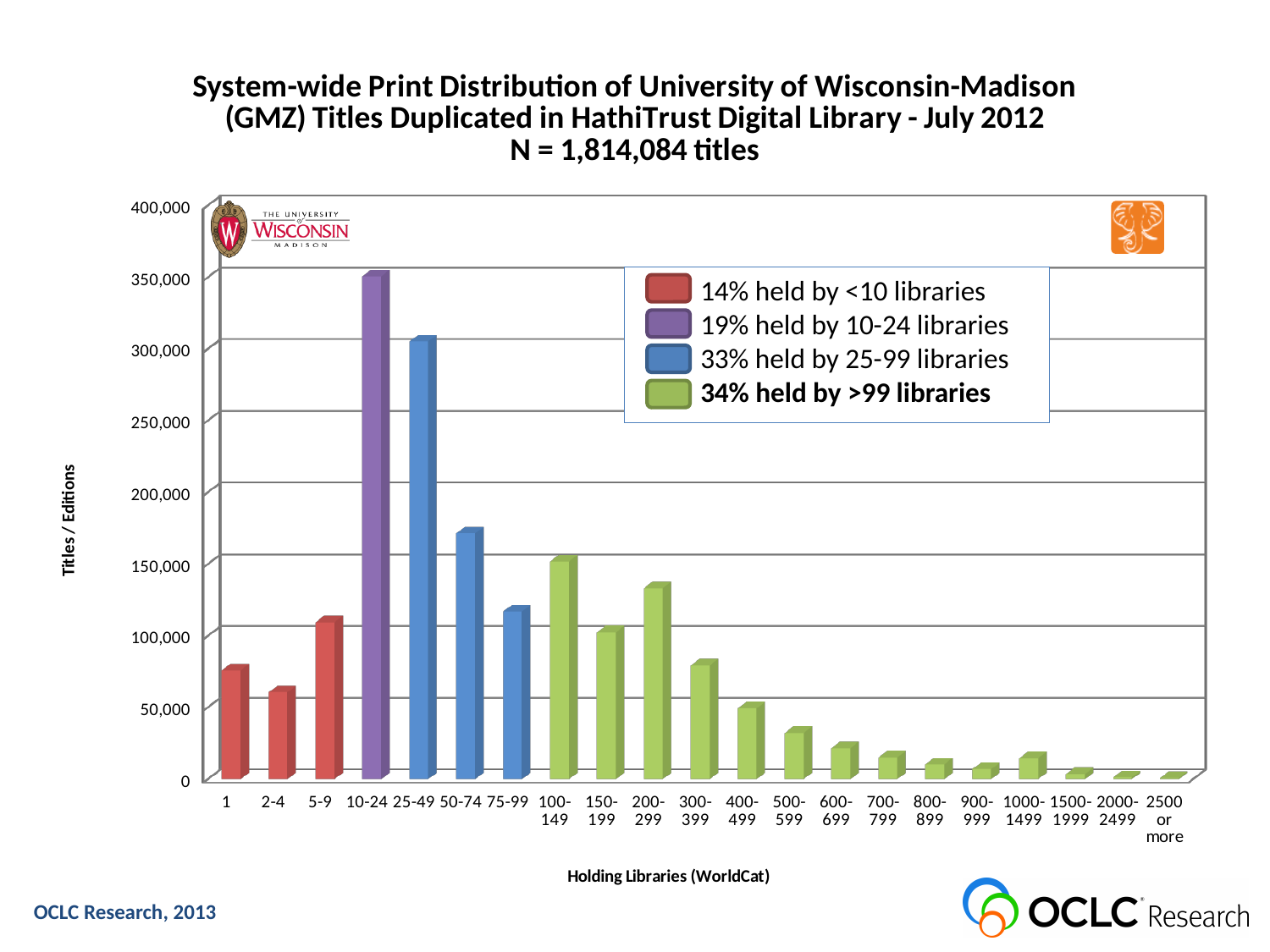
According to the legend, what percentage of titles is held by more than 99 libraries? 34% Which has more titles/editions, the 10-24 category or the 25-49 category? 10-24 Is the value for the 10-24 category greater or less than 300,000? greater Is the value for the 50-74 category greater or less than 150,000? greater Which has more titles/editions, the 1 category or the 2-4 category? 1 Is the value for the 200-299 category greater or less than 100,000? greater What kind of chart is shown on the slide? Bar chart How many holding-library categories are shown along the x axis? 21 From the 100-149 category onward to the right, do the values generally rise or fall? fall How many entries does the legend list? 4 Which holding-library category has the highest number of titles/editions? 10-24